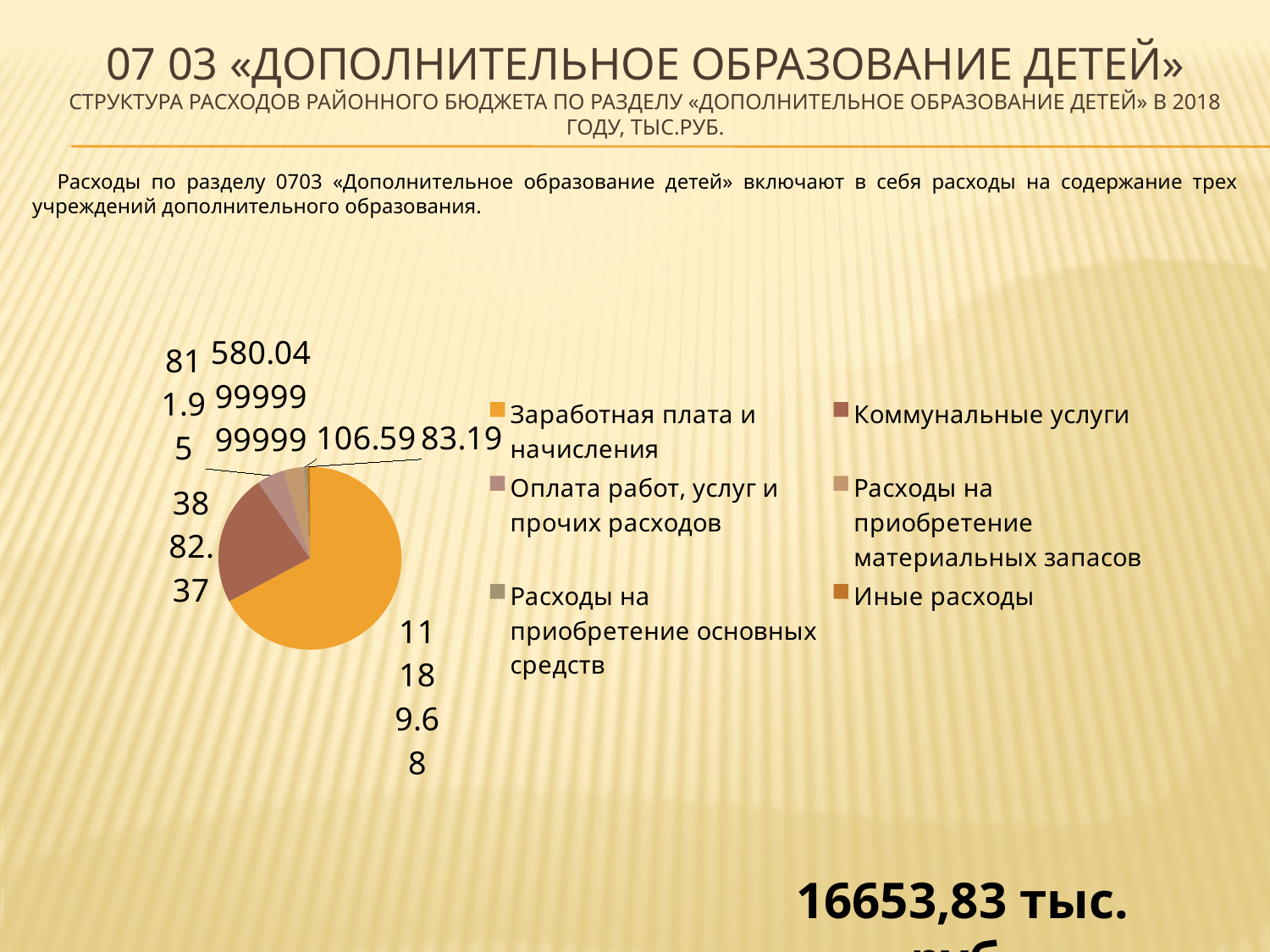
What is the difference between the values for Заработная плата и начисления and Коммунальные услуги? 7307.31 What is the value shown for Коммунальные услуги? 3882.37 In what units are the expenditures in the chart expressed, according to the slide subtitle? тыс.руб. How many entries does the legend of the pie chart list? 6 What is the value shown for Заработная плата и начисления? 11189.68 What kind of chart is shown on the slide? pie chart Which category has the smallest slice in the pie chart? Иные расходы How many slices does the pie chart have? 6 What total amount is printed in large text at the bottom right of the slide? 16653,83 тыс. руб. Which is larger, the value for Заработная плата и начисления or the value for Коммунальные услуги? Заработная плата и начисления Which category has the largest slice in the pie chart? Заработная плата и начисления